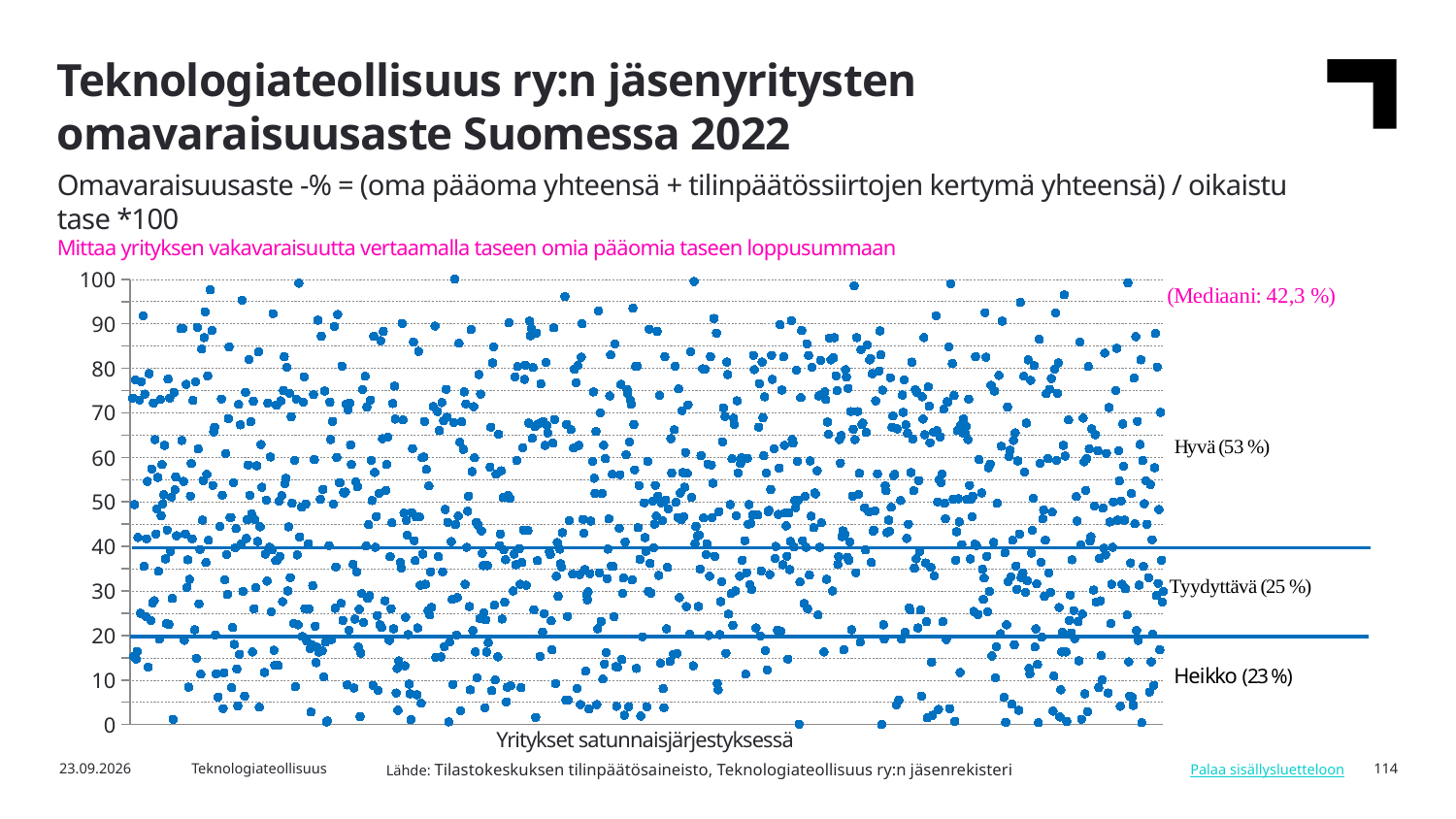
What median value is printed on the chart? 42,3 % What is the highest value shown on the y axis? 100 What is the difference in percentage points between the Hyvä share and the Heikko share? 30 What percentage of companies is labelled as 'Heikko' on the chart? 23 % Which category has the largest share of companies: Hyvä, Tyydyttävä or Heikko? Hyvä Is the share of companies in the Tyydyttävä category larger than the share in the Heikko category? Yes Is the median value of 42,3 % greater or less than 40? greater Which category has the smallest share of companies: Hyvä, Tyydyttävä or Heikko? Heikko What kind of chart is shown on the slide? Scatter chart What percentage of companies is labelled as 'Hyvä' on the chart? 53 % What percentage of companies is labelled as 'Tyydyttävä' on the chart? 25 % At which y-axis values are the two horizontal reference lines drawn? 40 and 20